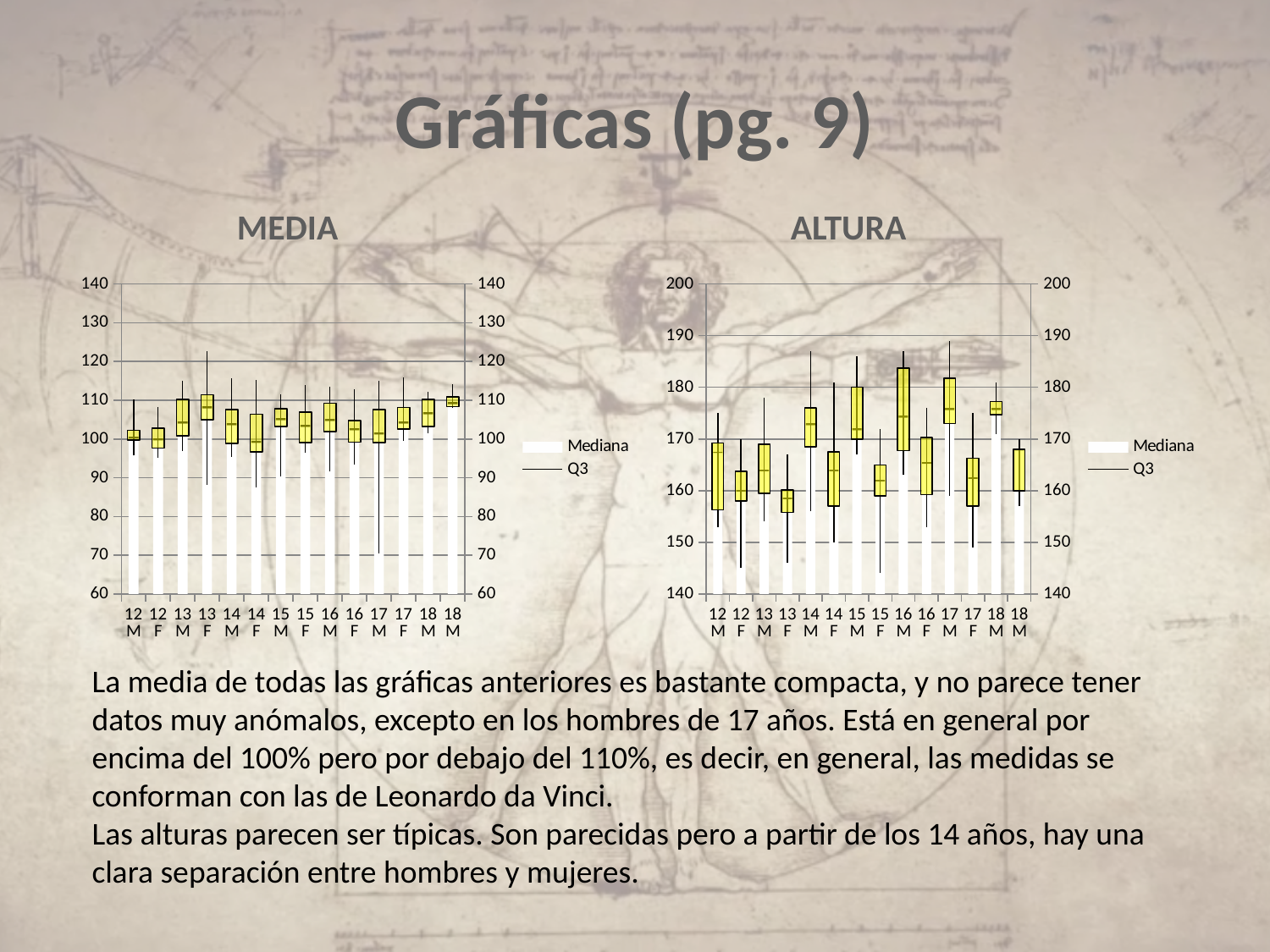
In the ALTURA chart, is the median value for 17 M greater or less than 170? greater What is the title of the chart on the right side of the slide? ALTURA In the MEDIA chart, is the median value for 18 M greater or less than 120? less In the MEDIA chart, how many categories are shown on the x axis? 14 In the ALTURA chart, how many series does the legend list? 2 In the MEDIA chart, what are the two legend entries? Mediana and Q3 In the ALTURA chart, which has the higher median value, 17 M or 17 F? 17 M In the MEDIA chart, which category's lower whisker extends furthest down the axis? 17 M In the ALTURA chart, is the median value for 15 F greater or less than 170? less In the ALTURA chart, which has the higher median value, 14 M or 14 F? 14 M